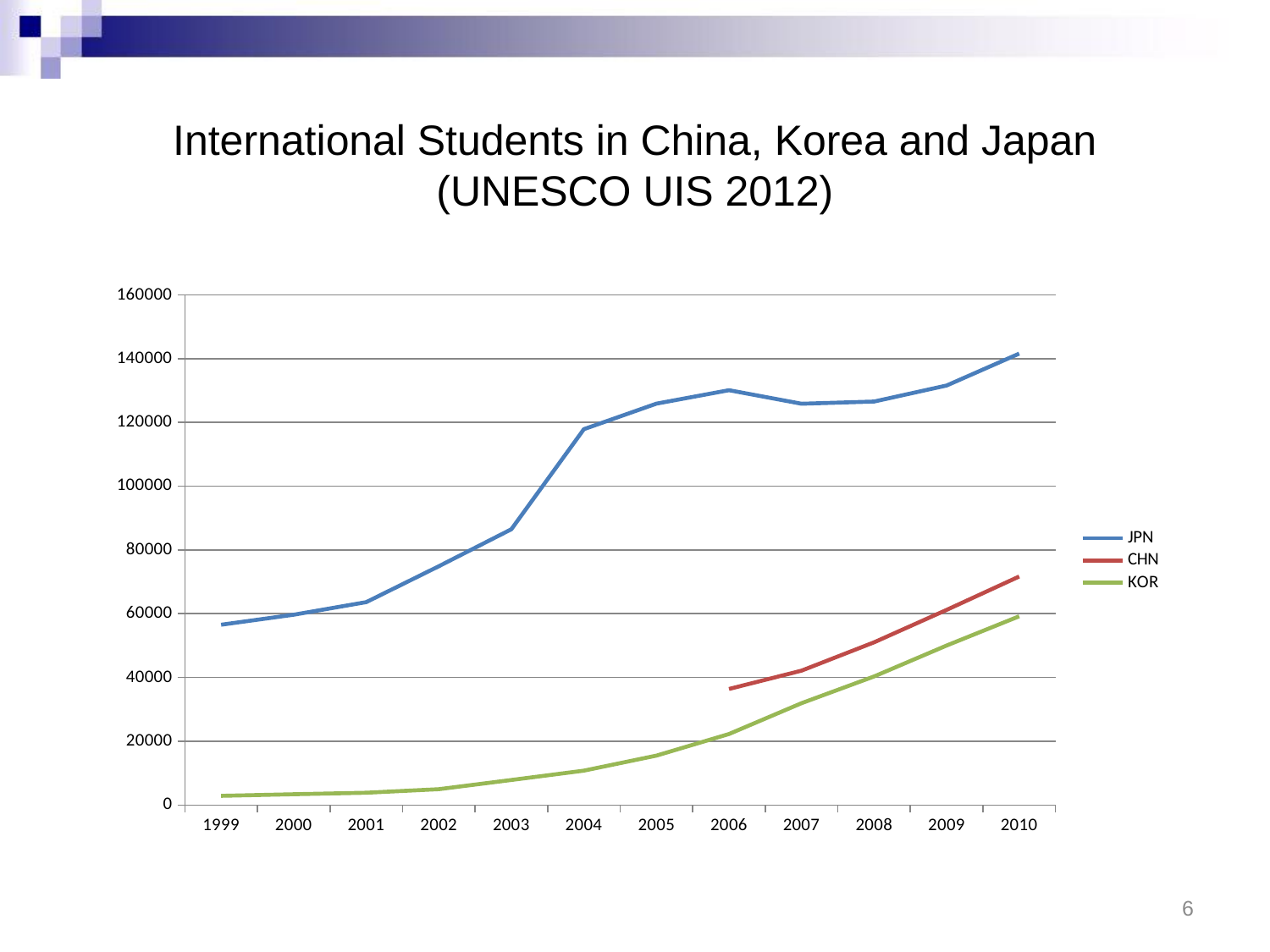
Does the KOR series rise or fall from 1999 to 2010? rise How many years are shown on the x axis? 12 Which series has the lowest value in 2010? KOR Which series has the highest value in 2010? JPN Is the value for KOR in 2010 greater or less than 40000? greater Is the value for JPN in 1999 greater or less than 60000? less Is the value for JPN in 2010 greater or less than 140000? greater In which year does the CHN series first appear on the chart? 2006 How many series does the legend list? 3 What kind of chart is shown on the slide? line chart Which is larger in 2008, the value for CHN or the value for KOR? CHN